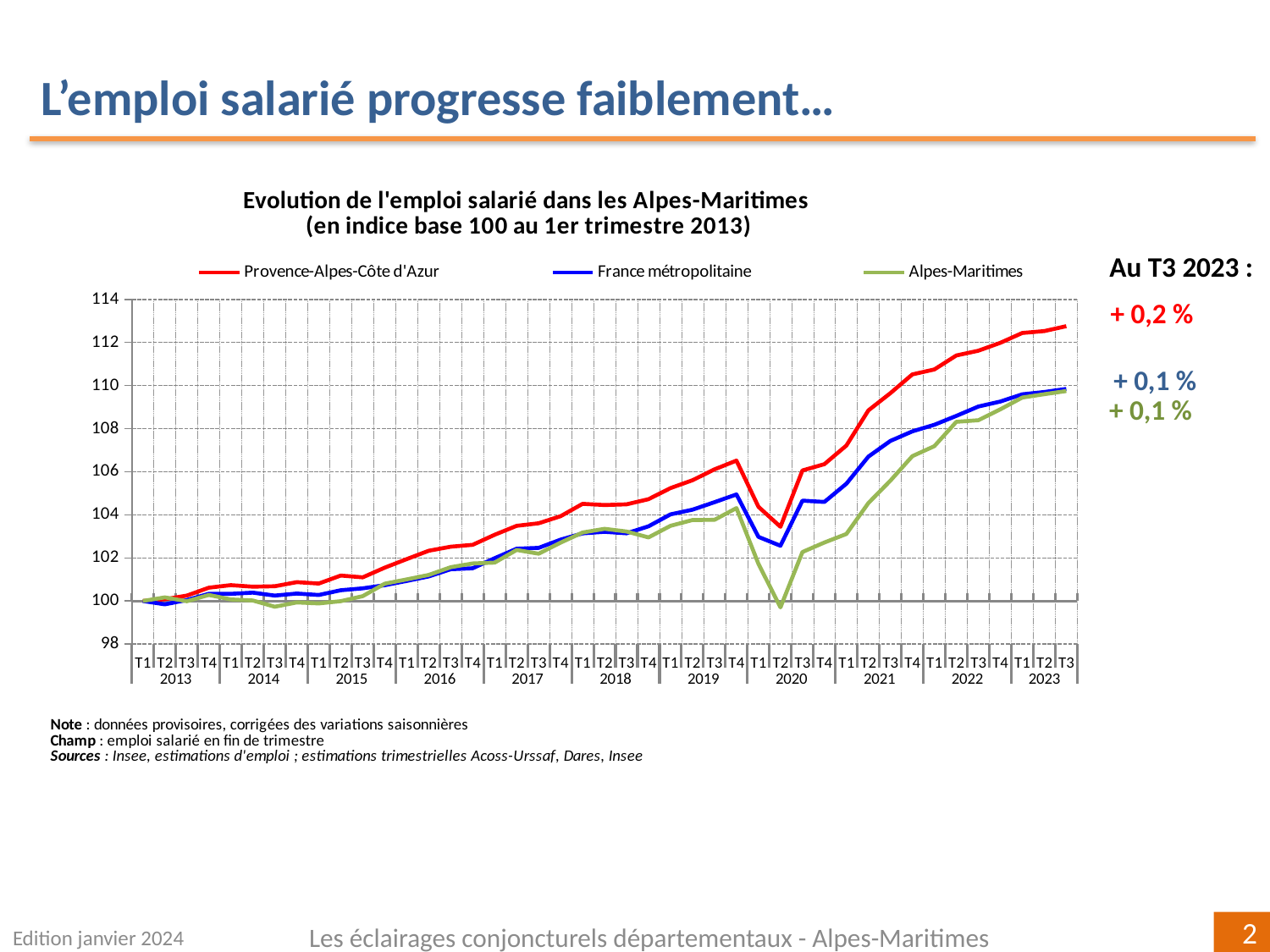
Does the Provence-Alpes-Côte d'Azur series overall rise or fall between T1 2013 and T3 2023? Rise According to the annotation on the right, what is the change for Provence-Alpes-Côte d'Azur at T3 2023? + 0,2 % What is the title of the chart? Evolution de l'emploi salarié dans les Alpes-Maritimes (en indice base 100 au 1er trimestre 2013) Is the value for Provence-Alpes-Côte d'Azur at T3 2023 greater or less than 112? greater Is the value for Alpes-Maritimes at T2 2020 greater or less than 102? less How many series does the legend list? 3 Is the value for France métropolitaine at T3 2023 greater or less than 112? less Which series is drawn in green in the chart? Alpes-Maritimes Which series has the highest value at T3 2023? Provence-Alpes-Côte d'Azur Which series has the lowest value at T2 2020? Alpes-Maritimes What kind of chart is shown on the slide? Line chart